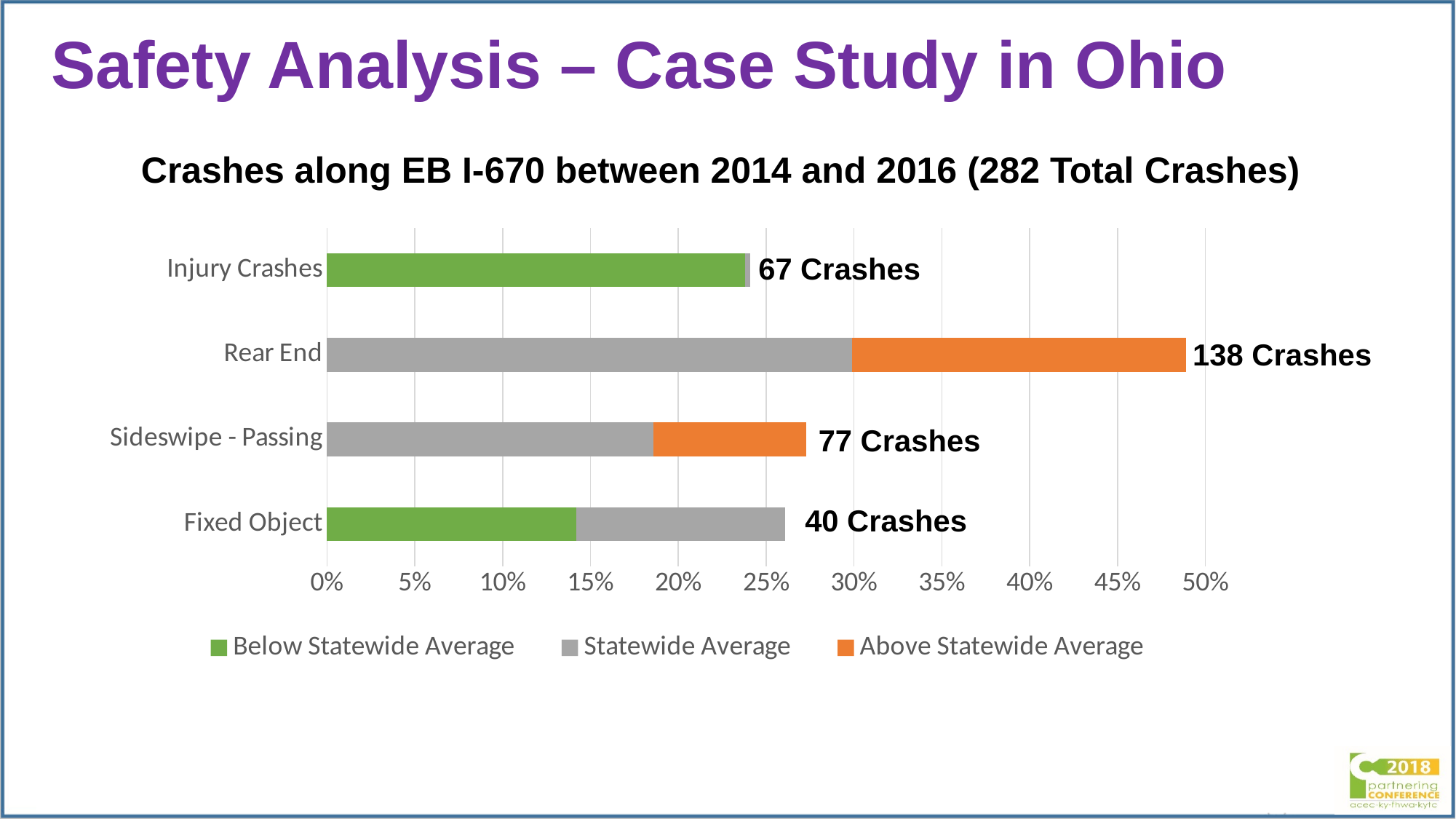
Is the bar for Injury Crashes greater or less than 25%? less How many categories are shown on the chart? 4 How many crashes are labelled for the Fixed Object category? 40 Crashes What is the difference in crash count between Rear End and Injury Crashes? 71 How many crashes are labelled for the Sideswipe - Passing category? 77 Crashes Is the total bar length for Rear End greater or less than 45%? greater How many crashes are labelled for the Rear End category? 138 Crashes What type of chart is shown on the slide? bar chart Which category has the lowest number of crashes? Fixed Object How many series does the legend list? 3 Which category has the highest number of crashes? Rear End Which has more crashes, Injury Crashes or Sideswipe - Passing? Sideswipe - Passing